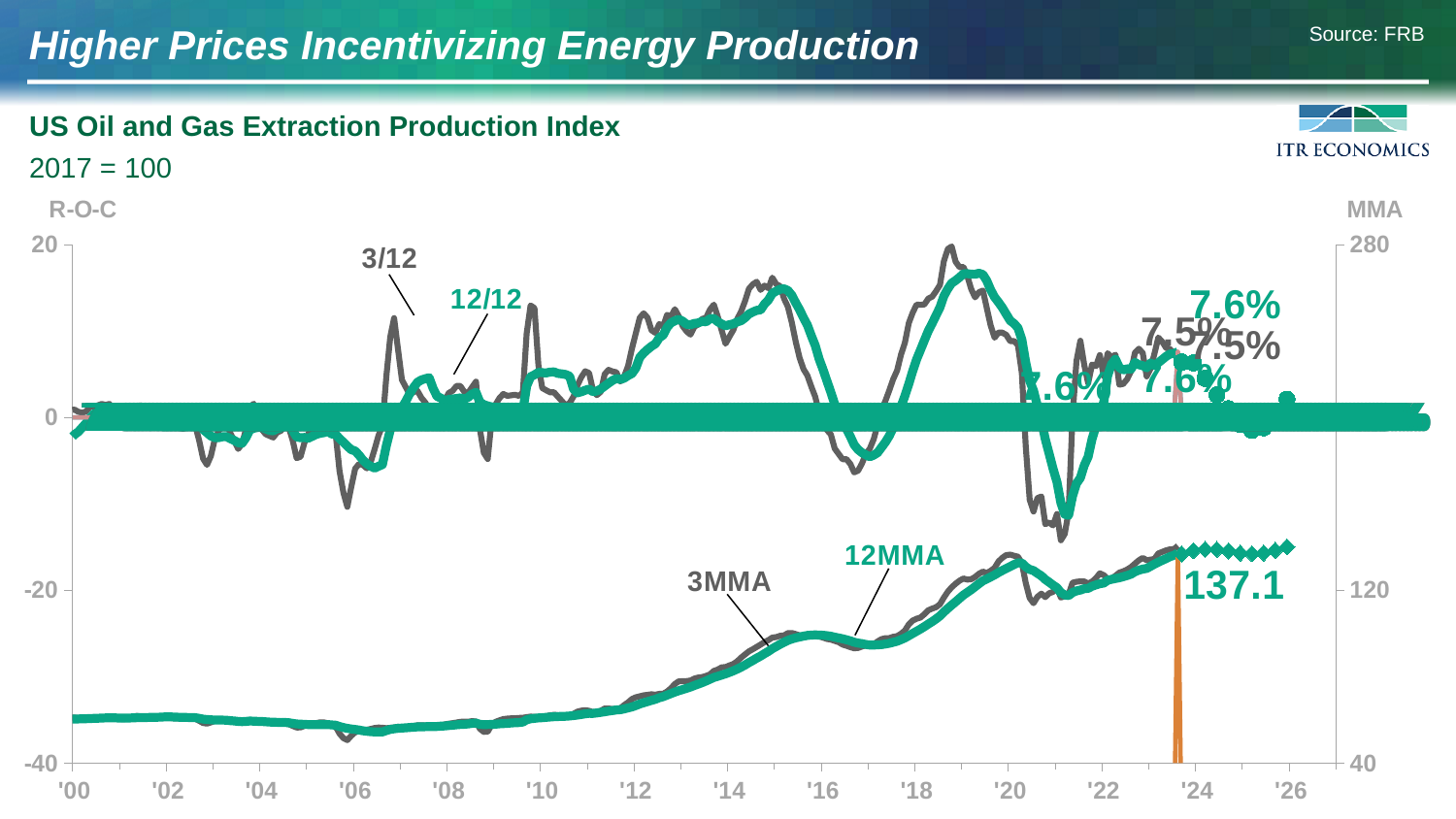
What is the highest value shown on the right-hand MMA axis? 280 What is the lowest value shown on the left-hand R-O-C axis? -40 What is the latest labeled value of the 3/12 rate-of-change series? 7.5% Does the 12MMA series rise or fall between 2012 and 2020? Rise What is the latest labeled value of the 12/12 rate-of-change series? 7.6% Which is larger, the 12/12 value at its 2019 peak or its 2021 trough? 2019 peak Is the 12MMA value in 2016 greater or less than 120 on the MMA axis? less How many data series are labeled on the chart? 4 What is the base year of the index, as stated on the slide? 2017 = 100 What kind of chart is shown on the slide? Line chart What is the latest labeled value of the 12MMA series? 137.1 What is the title of the chart? US Oil and Gas Extraction Production Index